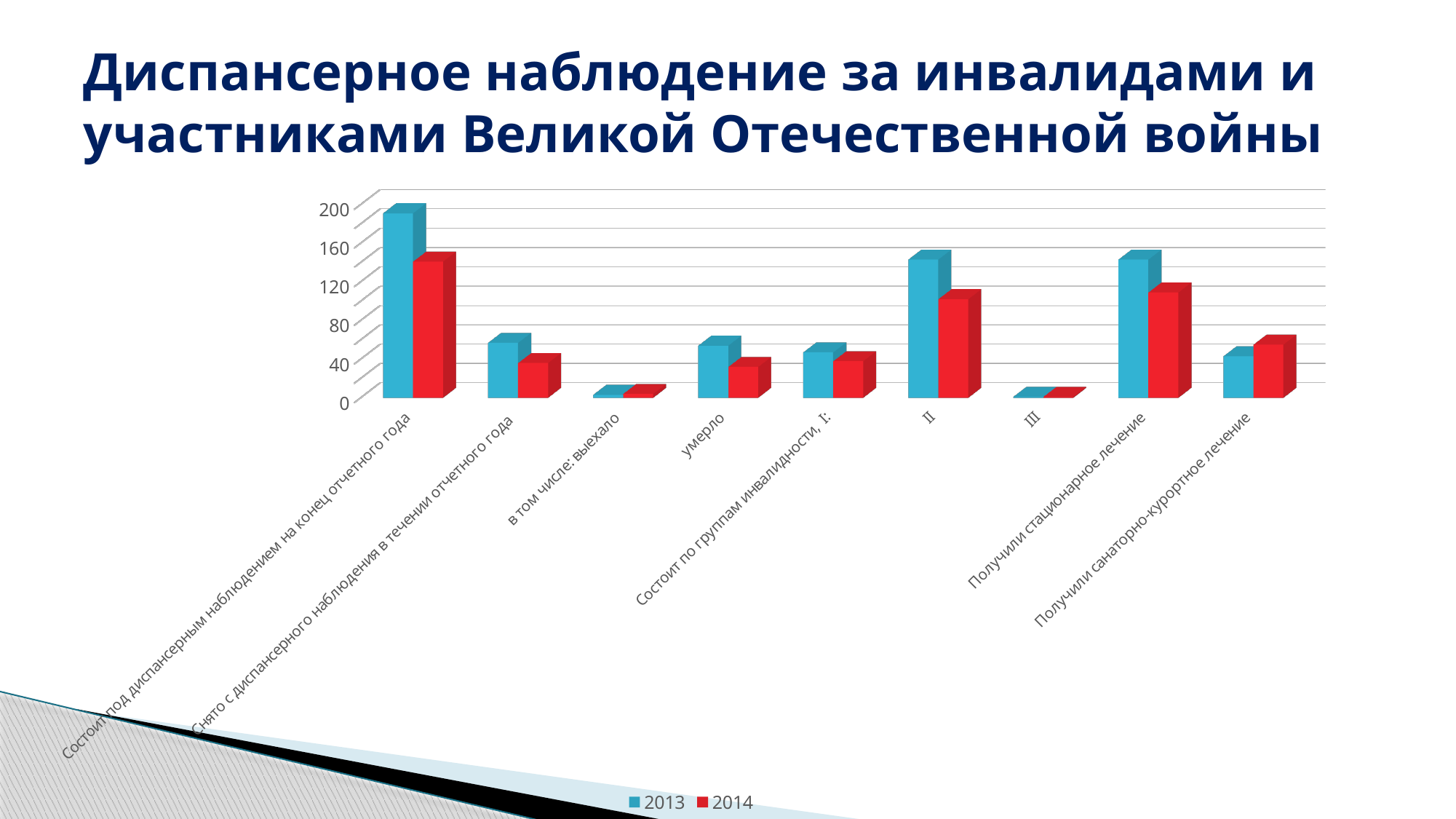
Is the 2013 value for 'II' greater or less than 120? greater Which category has the highest value for 2013? Состоит под диспансерным наблюдением на конец отчетного года For 'Получили санаторно-курортное лечение', which year has the larger value, 2013 or 2014? 2014 Which years are listed in the legend? 2013 and 2014 For 'Состоит под диспансерным наблюдением на конец отчетного года', which year has the larger value, 2013 or 2014? 2013 Is the 2013 value for 'Состоит под диспансерным наблюдением на конец отчетного года' greater or less than 160? greater Is the 2014 value for 'Получили стационарное лечение' greater or less than 80? greater What kind of chart is shown on the slide? bar chart How many series does the legend list? 2 How many categories are shown on the x axis? 9 What colour represents the 2014 series? red